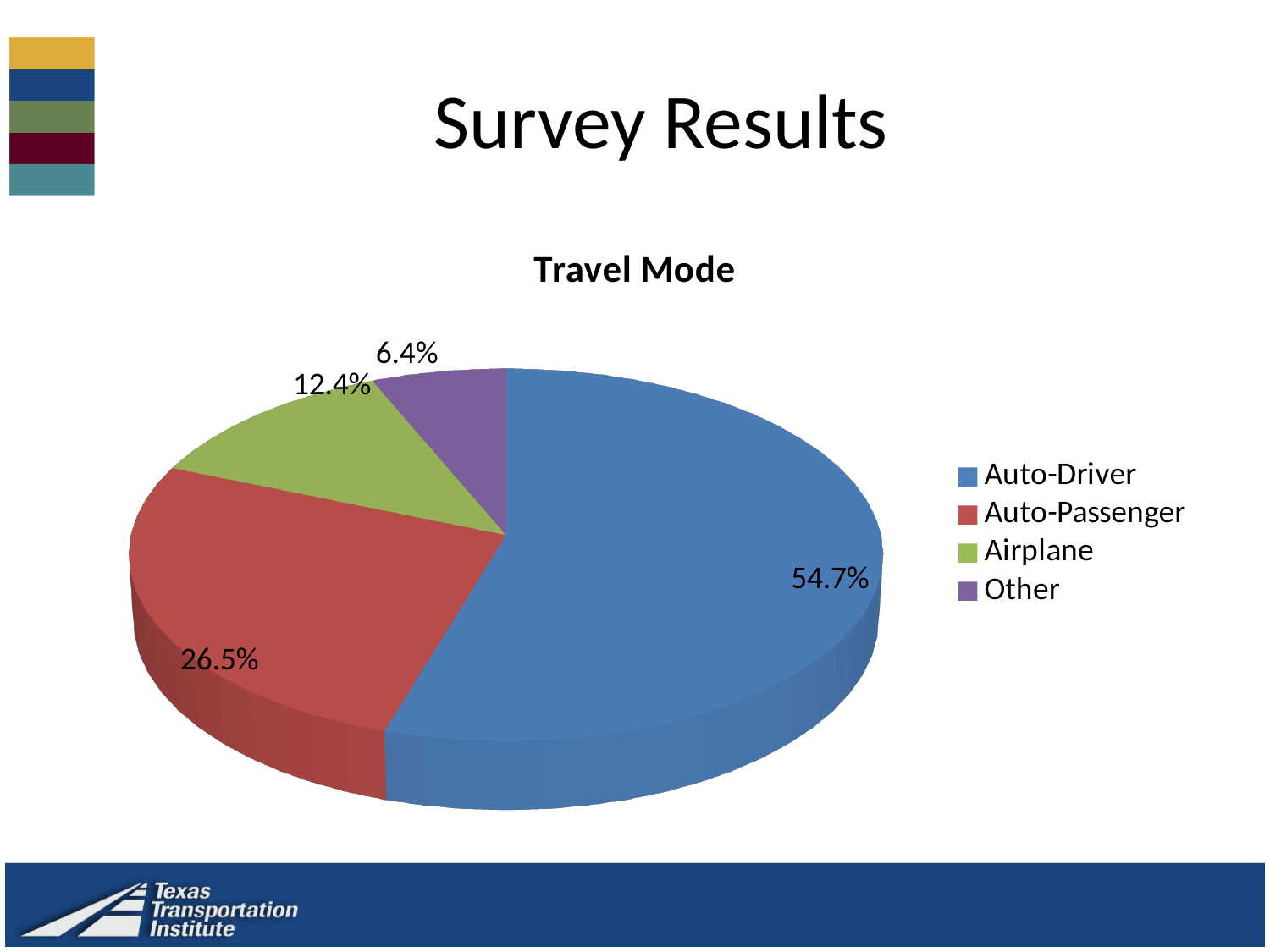
Which travel mode has the smallest share? Other How many categories does the legend list? 4 What kind of chart is shown on the slide? Pie chart What share of the pie is Airplane? 12.4% What colour is the Airplane slice? Green Which travel mode has the largest share? Auto-Driver What share of the pie is Auto-Passenger? 26.5% Which is larger, the Airplane share or the Other share? Airplane What is the difference in percentage points between Auto-Driver and Auto-Passenger? 28.2 What share of the pie is Auto-Driver? 54.7% What share of the pie is Other? 6.4% What is the title of the chart? Travel Mode